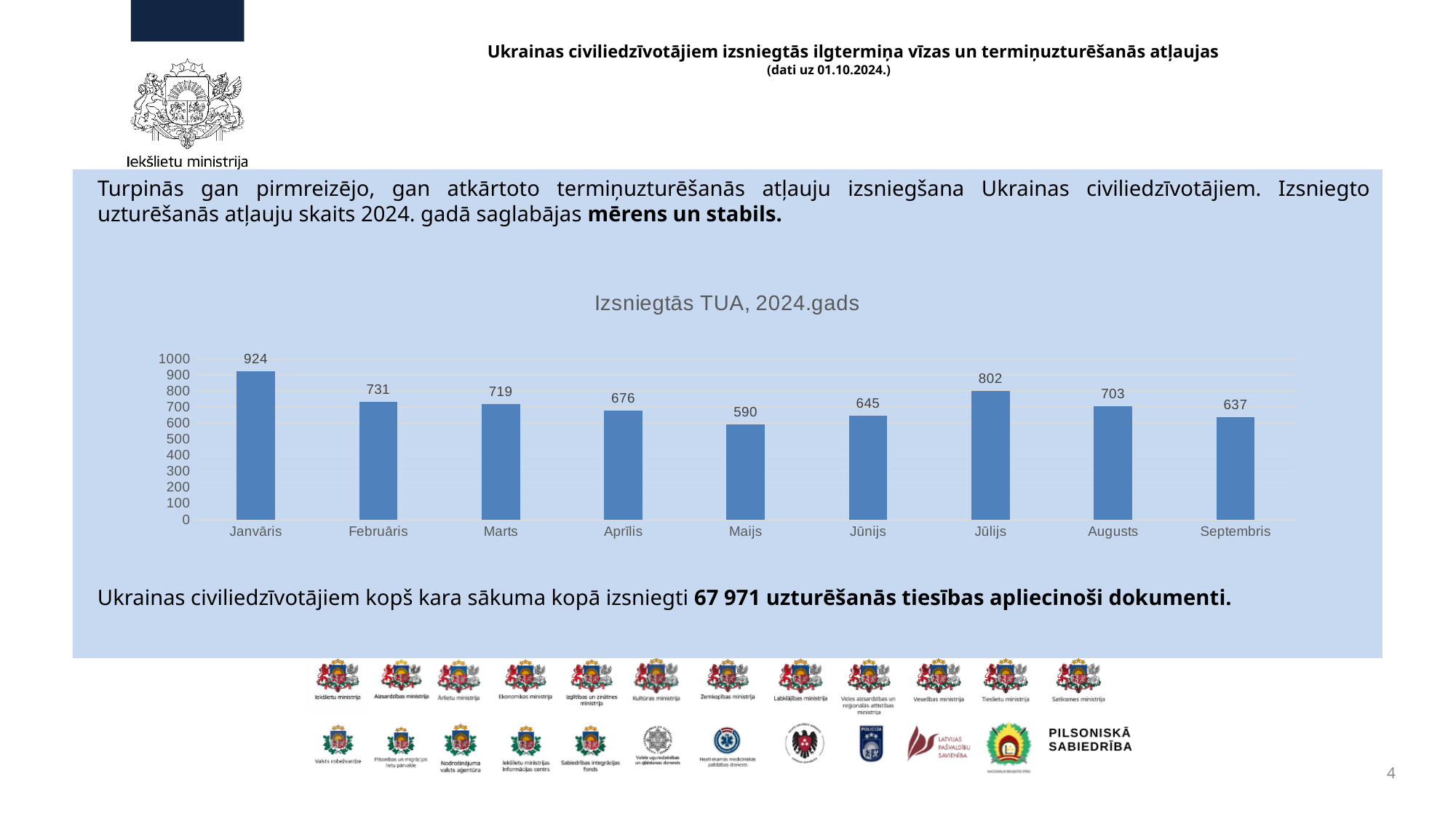
Which month has the highest value? Janvāris What is the value for Maijs? 590 What is the value for Jūlijs? 802 What is the difference between the values for Janvāris and Februāris? 193 Is the value for Septembris greater or less than 700? less Which is larger, the value for Marts or the value for Aprīlis? Marts What is the title of the chart? Izsniegtās TUA, 2024.gads What kind of chart is shown on the slide? bar chart How many months are shown on the chart? 9 What is the value for Janvāris? 924 What is the difference between the values for Jūlijs and Augusts? 99 Which month has the lowest value? Maijs